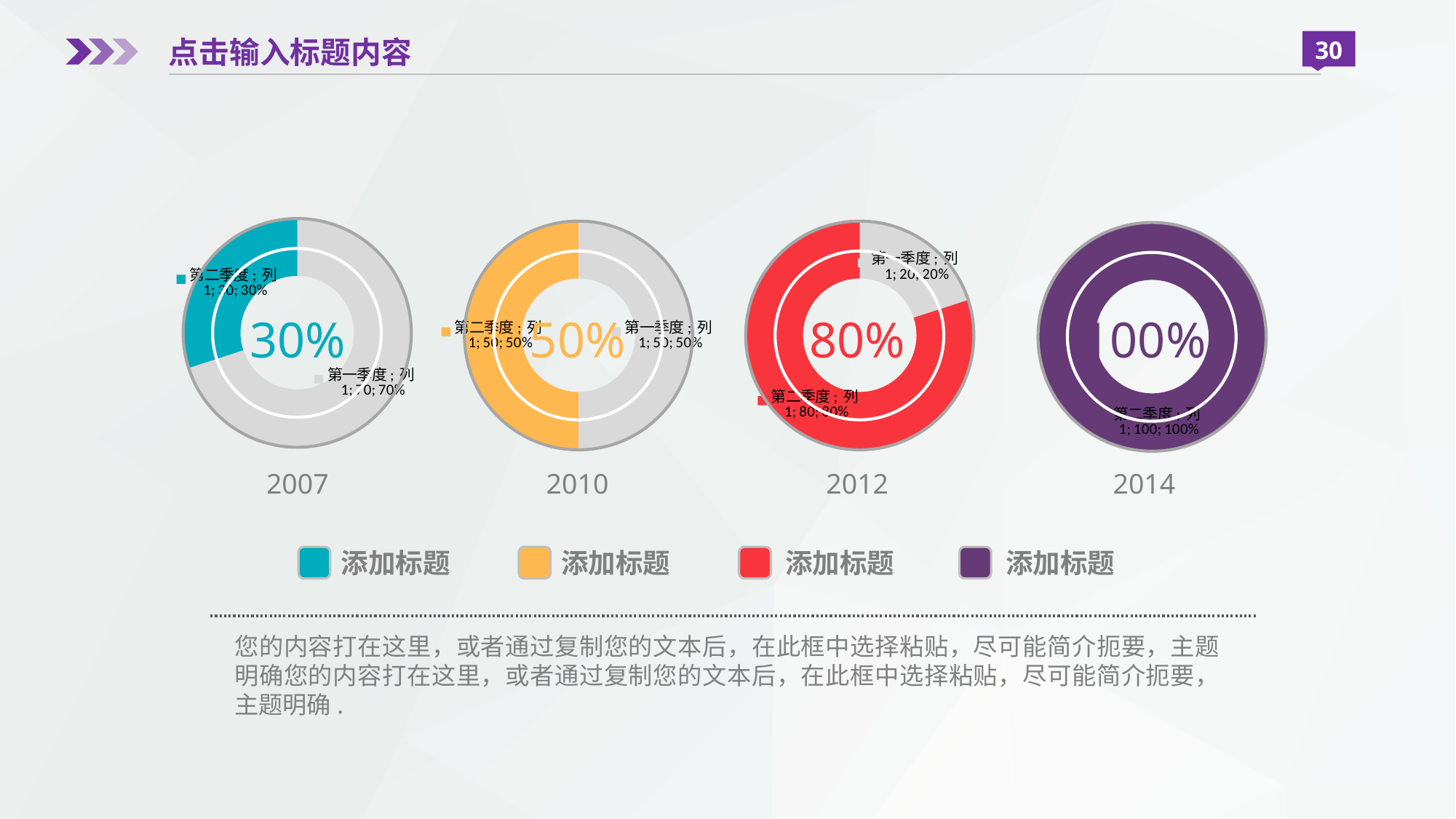
Do the centre percentages rise or fall from the 2007 chart to the 2014 chart? rise In the doughnut chart labelled 2012, what share does the 第一季度 slice have? 20% In the doughnut chart labelled 2010, what percentage is shown in the centre? 50% How many doughnut charts are on the slide? 4 Which of the four doughnut charts shows the highest centre percentage? 2014 Which of the four doughnut charts shows the lowest centre percentage? 2007 In the doughnut chart labelled 2007, what percentage is shown in the centre? 30% In the doughnut chart labelled 2014, what percentage is shown in the centre? 100% In the doughnut chart labelled 2012, what percentage is shown in the centre? 80% What is the difference between the centre percentages of the 2012 and 2007 doughnut charts? 50% In the doughnut chart labelled 2007, what share does the 第一季度 slice have? 70% What kind of chart is shown under the label 2007? doughnut chart